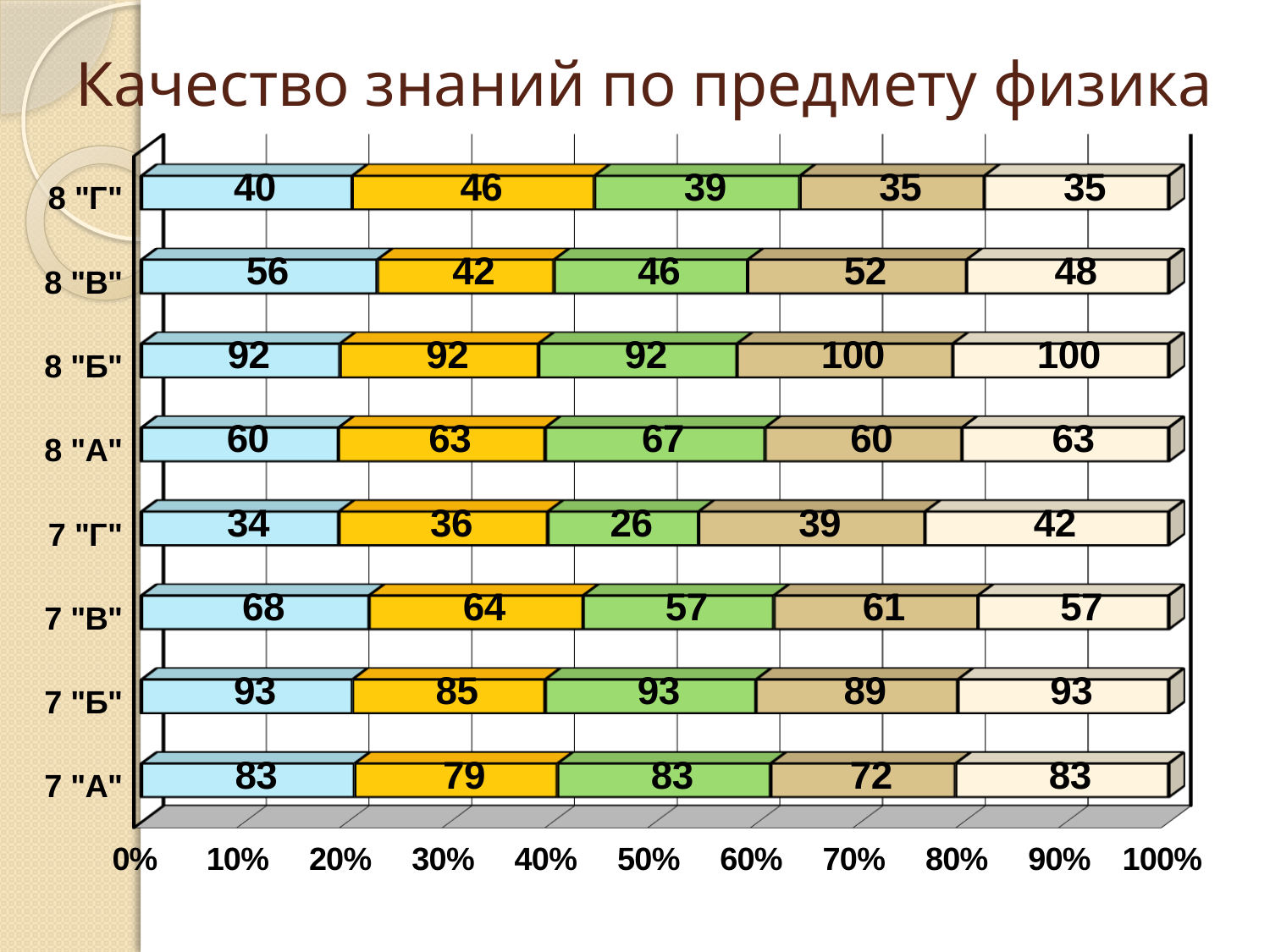
What kind of chart is shown on the slide? Stacked bar chart For class 8 "Г", what is the difference between the yellow segment and the light blue segment? 6 Which class has the lowest value in the first (light blue) segment? 7 "Г" Which class has the larger light blue segment value: 7 "В" or 7 "Г"? 7 "В" Which is the smallest value among the segments of the 7 "Г" bar? 26 How many segments does each stacked bar contain? 5 What is the title of the chart? Качество знаний по предмету физика What is the value of the green segment for class 8 "А"? 67 What is the value of the last (cream-coloured) segment for class 7 "Г"? 42 What is the value of the yellow segment for class 7 "Б"? 85 How many classes (categories) are shown on the vertical axis? 8 What is the value of the first (light blue) segment for class 8 "В"? 56